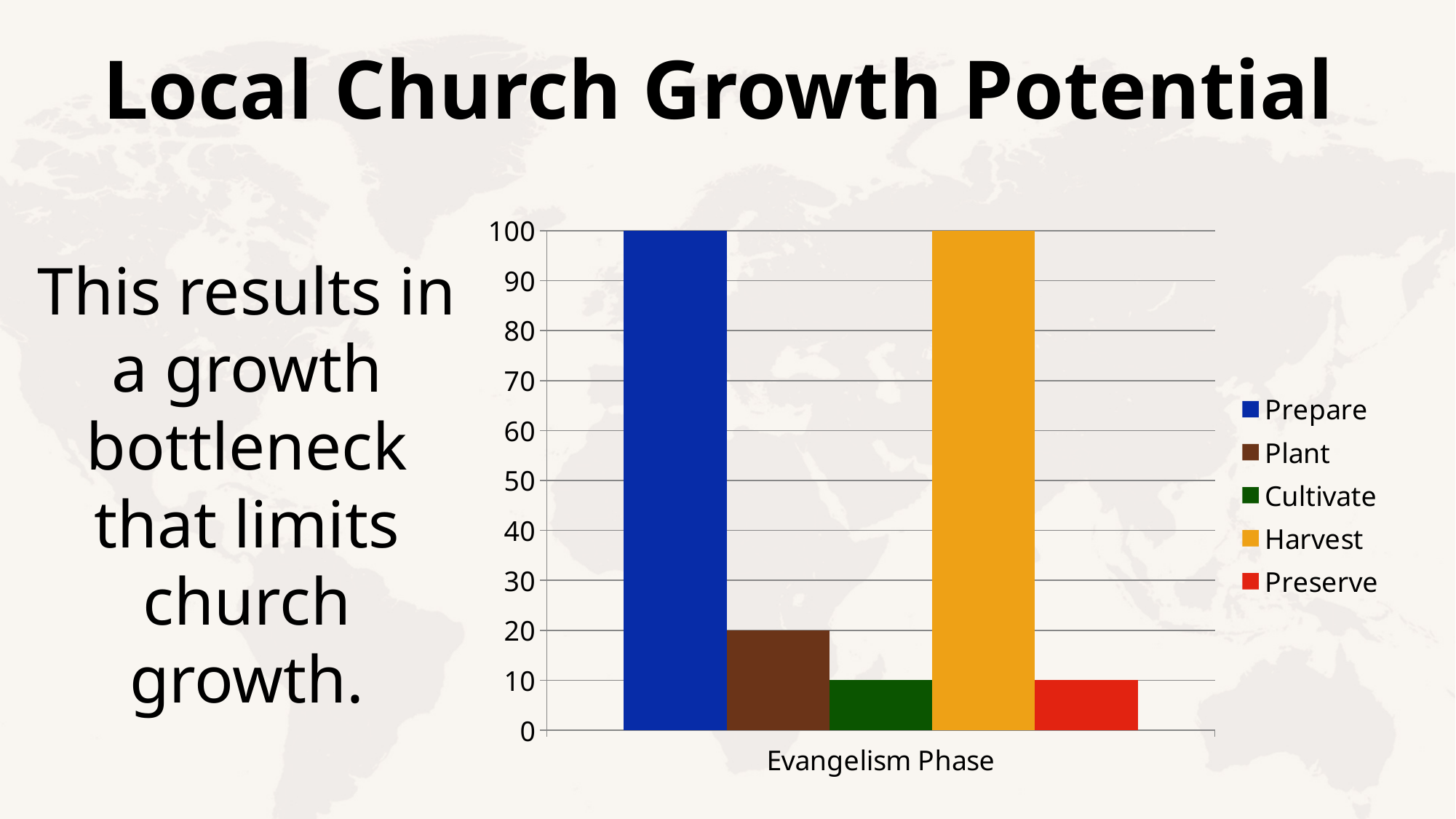
What is the difference between the values for Harvest and Preserve? 90 What kind of chart is shown on the slide? bar chart What is the value for Prepare? 100 What is the value for Preserve? 10 How many series does the legend list? 5 What is the value for Cultivate? 10 What is the label on the x axis of the chart? Evangelism Phase Is the value for Plant greater or less than 50? less What is the difference between the values for Plant and Cultivate? 10 What is the value for Plant? 20 What is the value for Harvest? 100 Which is larger, the value for Prepare or the value for Plant? Prepare